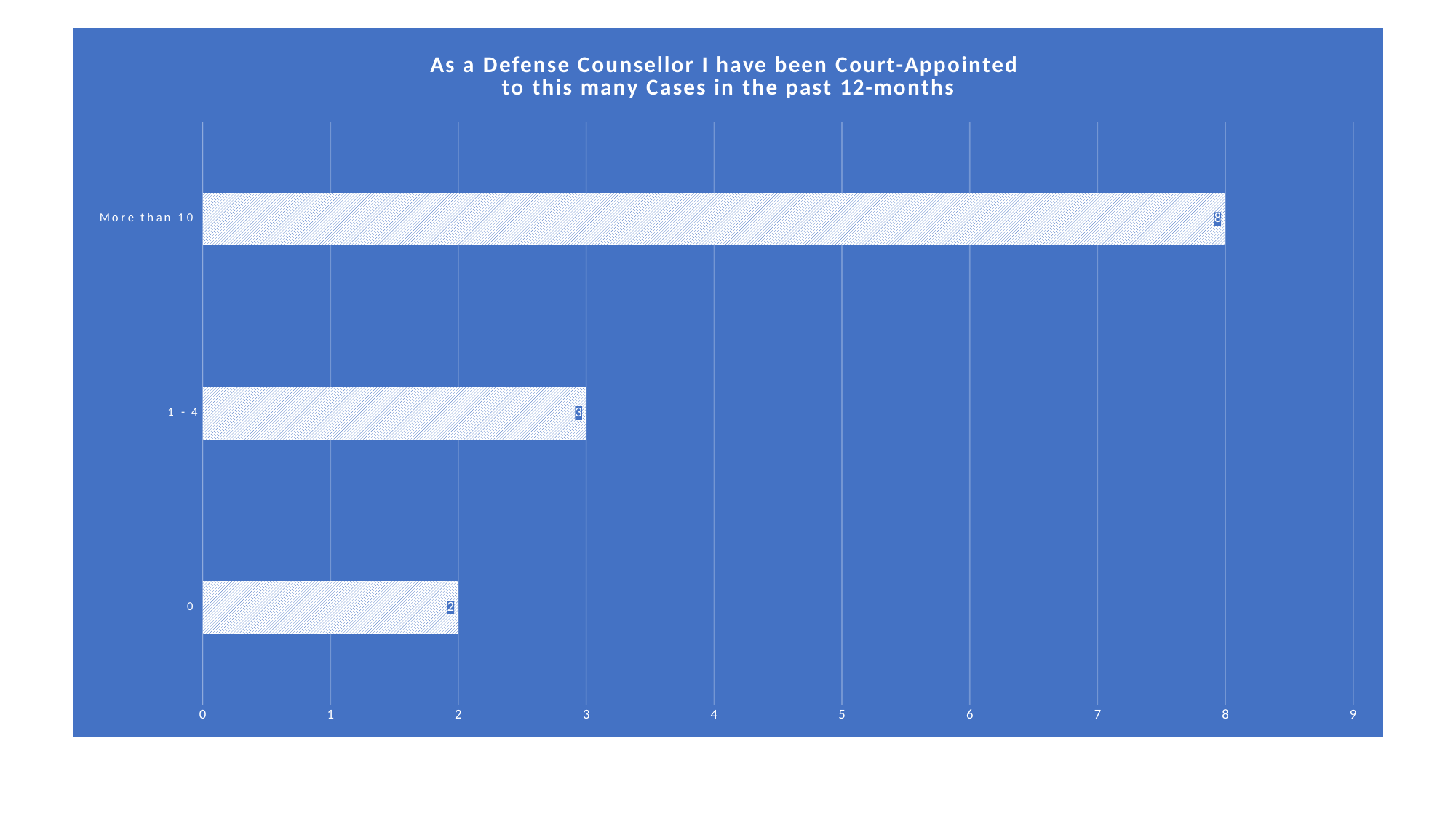
What is the title of the chart? As a Defense Counsellor I have been Court-Appointed to this many Cases in the past 12-months What is the difference between the values for "1 - 4" and "0"? 1 What is the value for the "More than 10" category? 8 What is the value for the "1 - 4" category? 3 Which category has the lowest value? 0 What kind of chart is shown on the slide? bar chart Which category has the highest value? More than 10 Is the value for "More than 10" greater or less than 5? greater Which is larger, the value for "1 - 4" or the value for "0"? 1 - 4 How many categories are shown in the chart? 3 What is the difference between the values for "More than 10" and "1 - 4"? 5 What is the value for the "0" category? 2